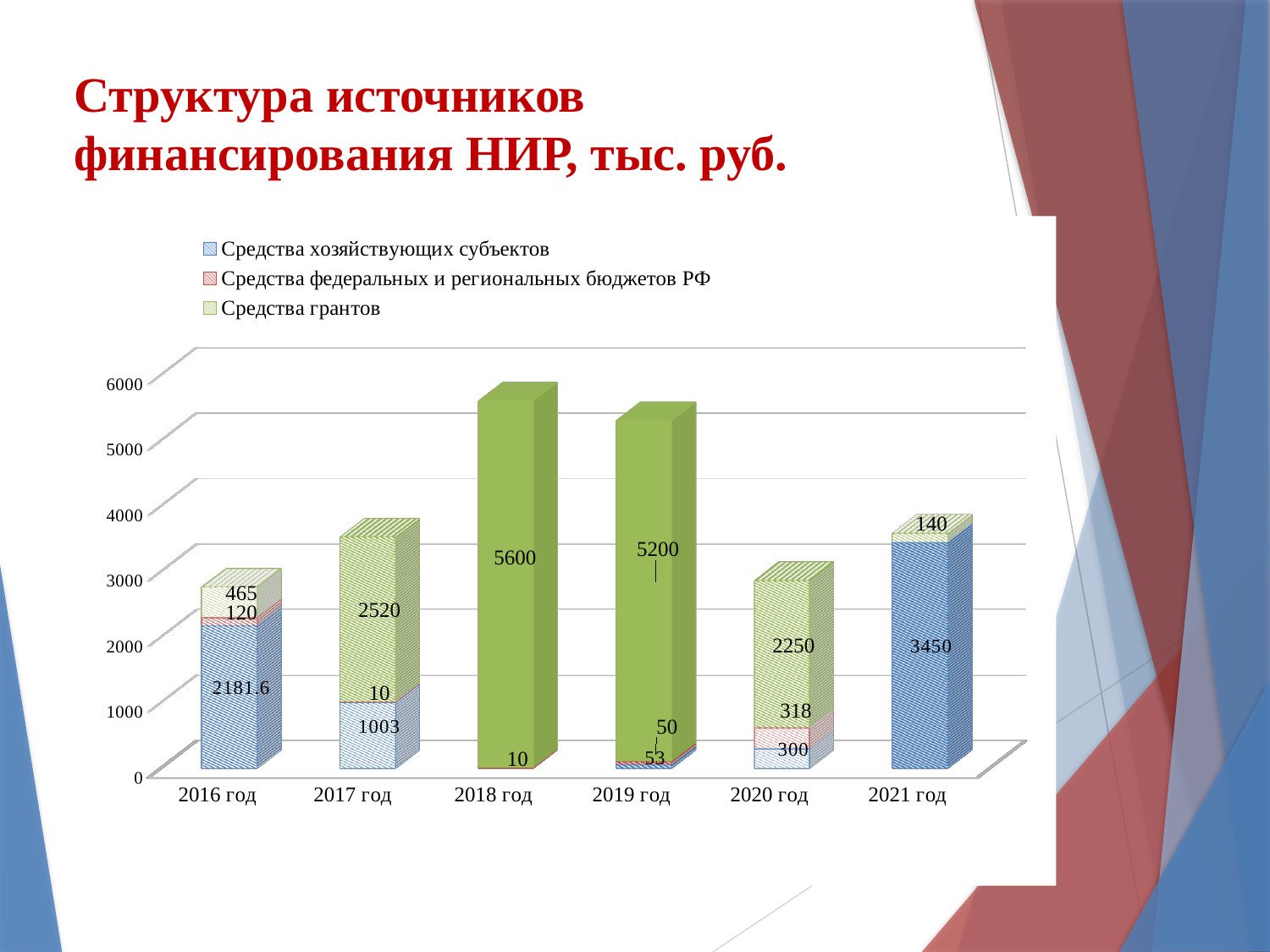
Is the total height of the stacked bar for 2018 год greater or less than 5000? greater Which year has the larger value for Средства хозяйствующих субъектов, 2017 год or 2021 год? 2021 год What kind of chart is shown on the slide? stacked bar chart What is the value of Средства федеральных и региональных бюджетов РФ for 2020 год? 318 What is the total of the stacked bar for 2017 год? 3533 What is the value of Средства грантов for 2018 год? 5600 How many years are shown on the x axis? 6 What is the difference between Средства грантов in 2018 год and 2019 год? 400 Which year has the lowest value for Средства грантов? 2021 год What is the value of Средства хозяйствующих субъектов for 2016 год? 2181.6 How many series does the legend list? 3 Which year has the highest value for Средства грантов? 2018 год